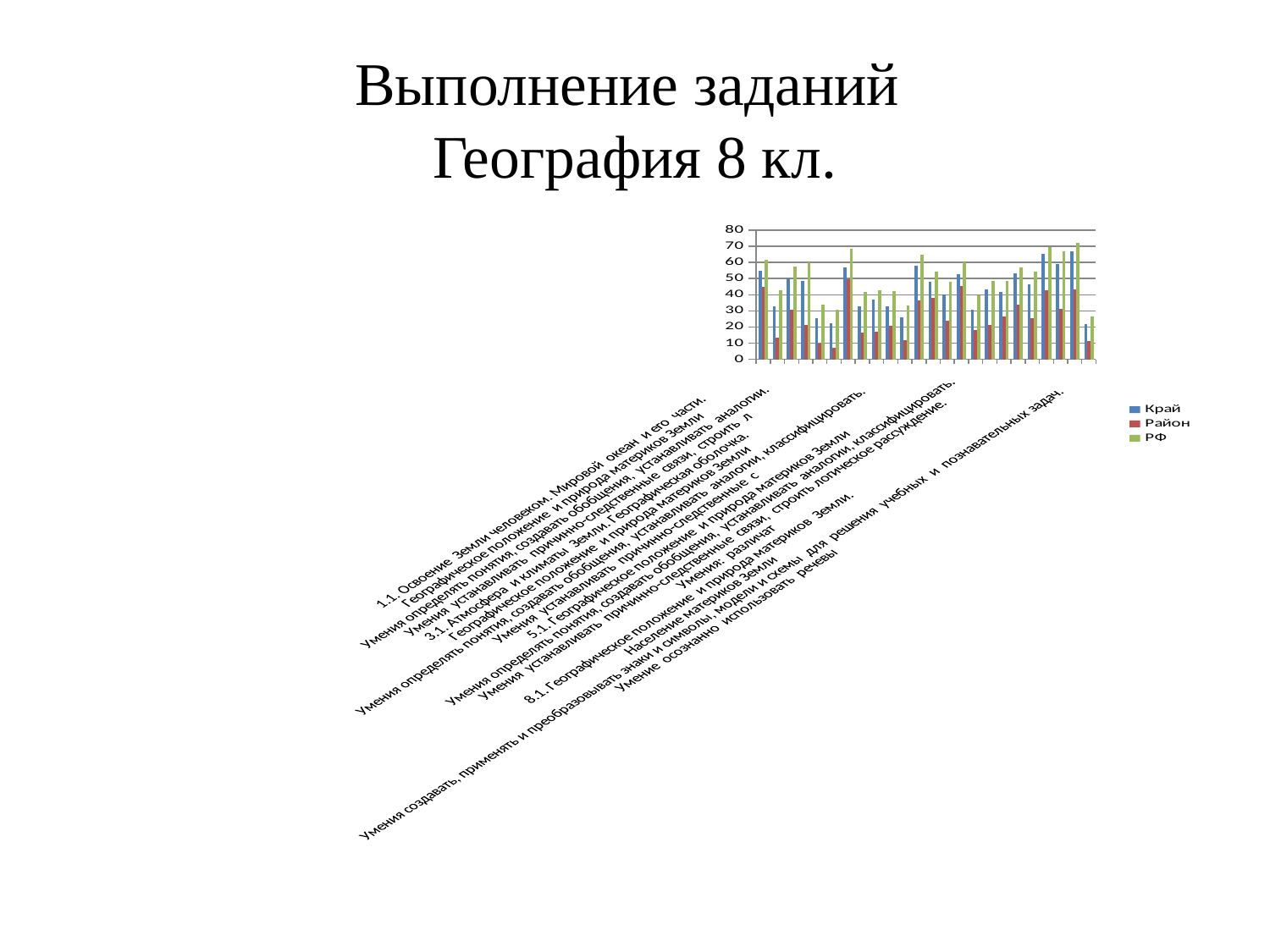
What is the highest value shown on the vertical axis? 80 Is the value for Край in the last category (Умение осознанно использовать речевы...) greater or less than 40? less Is the value for Район in the last category (Умение осознанно использовать речевы...) greater or less than 30? less Which colour represents the series РФ in the legend? Green What kind of chart is shown on the slide? Bar chart What are the series names listed in the legend? Край, Район, РФ In the first category (1.1. Освоение Земли человеком. Мировой океан и его части.), which is larger: the value for РФ or the value for Район? РФ How many series does the legend list? 3 In the last category (Умение осознанно использовать речевы...), which is larger: the value for Край or the value for Район? Край Is the value for Район in the first category (1.1. Освоение Земли человеком. Мировой океан и его части.) greater or less than 30? greater